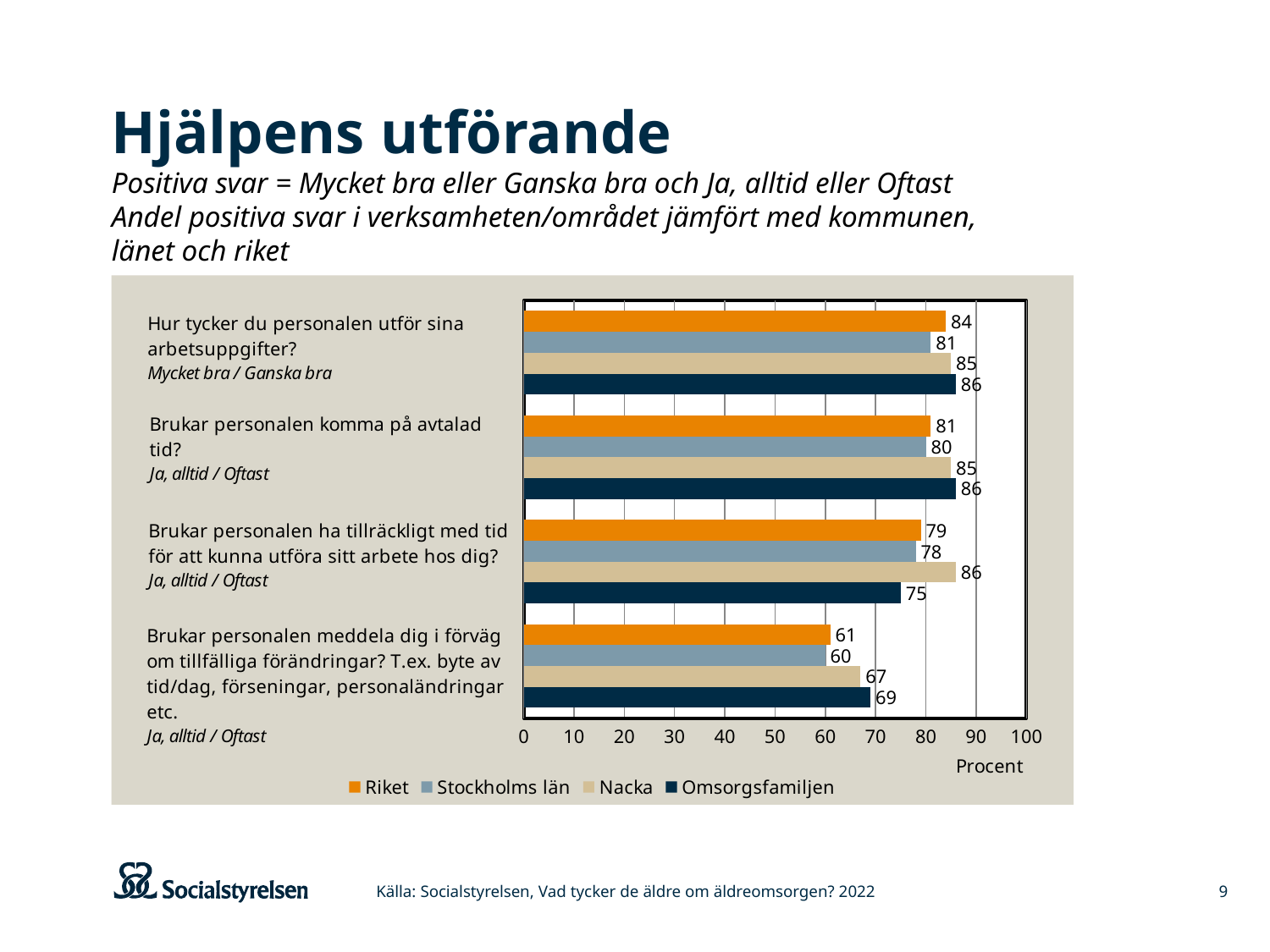
What is the difference between Nacka and Stockholms län for 'Brukar personalen meddela dig i förväg om tillfälliga förändringar?' 7 How many series does the legend list? 4 Which series has the lowest value for 'Brukar personalen ha tillräckligt med tid för att kunna utföra sitt arbete hos dig?' Omsorgsfamiljen What is the value for Nacka for 'Brukar personalen ha tillräckligt med tid för att kunna utföra sitt arbete hos dig?' 86 How many questions (categories) are plotted in the chart? 4 What is the label on the x axis of the chart? Procent What is the value for Riket for 'Brukar personalen meddela dig i förväg om tillfälliga förändringar?' 61 What kind of chart is shown on the slide? bar chart What is the value for Stockholms län for 'Brukar personalen komma på avtalad tid?' 80 What is the value for Omsorgsfamiljen for 'Hur tycker du personalen utför sina arbetsuppgifter?' 86 For 'Brukar personalen komma på avtalad tid?', which is larger: Riket or Nacka? Nacka Which series has the highest value for 'Brukar personalen meddela dig i förväg om tillfälliga förändringar?' Omsorgsfamiljen